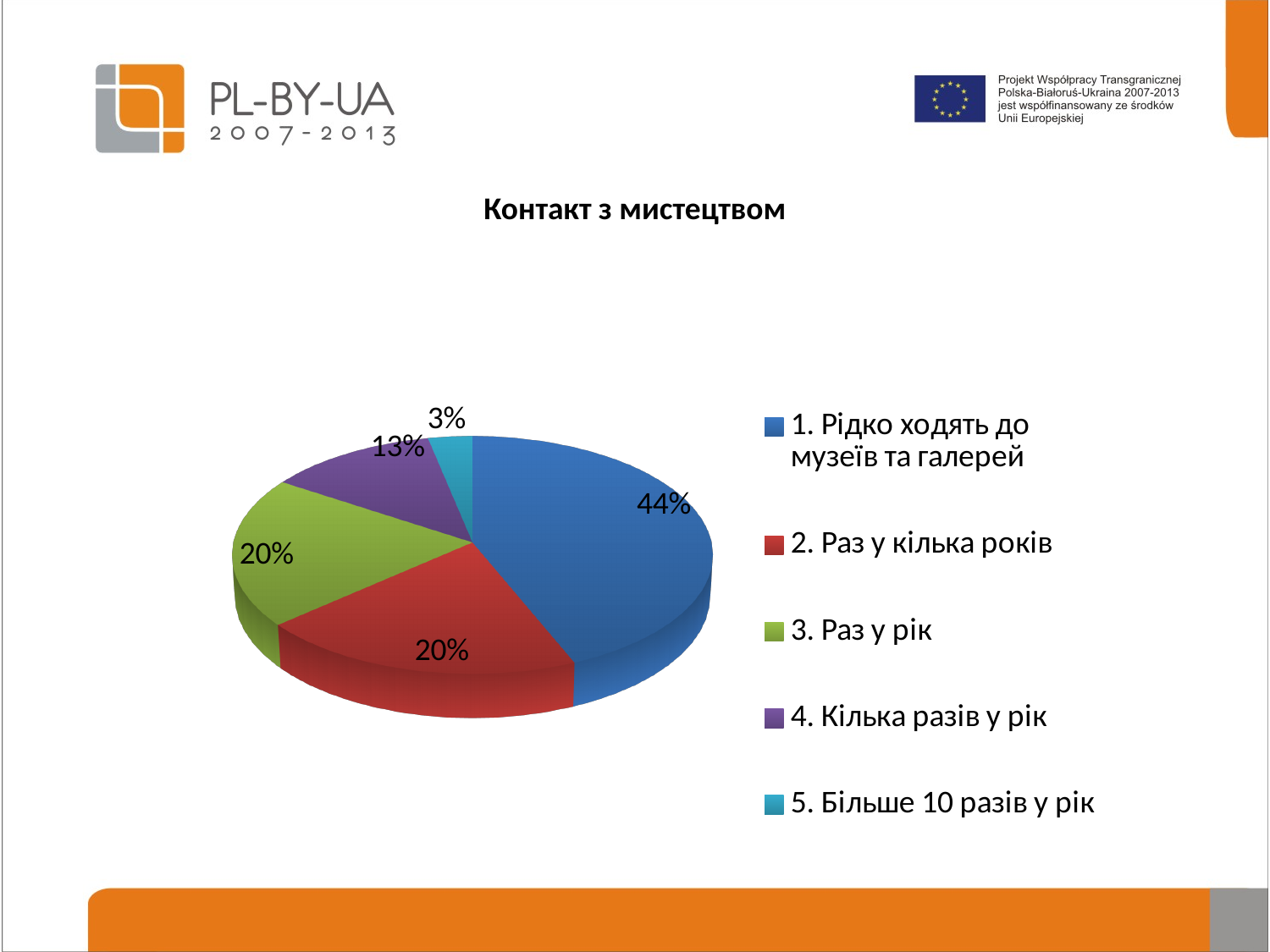
What kind of chart is shown on the slide? pie chart What share of the pie is labelled "1. Рідко ходять до музеїв та галерей"? 44% What share of the pie is labelled "4. Кілька разів у рік"? 13% Which is larger: the slice for "3. Раз у рік" or the slice for "4. Кілька разів у рік"? 3. Раз у рік Which category has the smallest slice of the pie? 5. Більше 10 разів у рік What share of the pie is labelled "5. Більше 10 разів у рік"? 3% What is the difference in percentage points between "1. Рідко ходять до музеїв та галерей" and "4. Кілька разів у рік"? 31 What colour is the slice for "2. Раз у кілька років"? red Which category has the largest slice of the pie? 1. Рідко ходять до музеїв та галерей What is the title of the chart? Контакт з мистецтвом How many slices does the pie chart have? 5